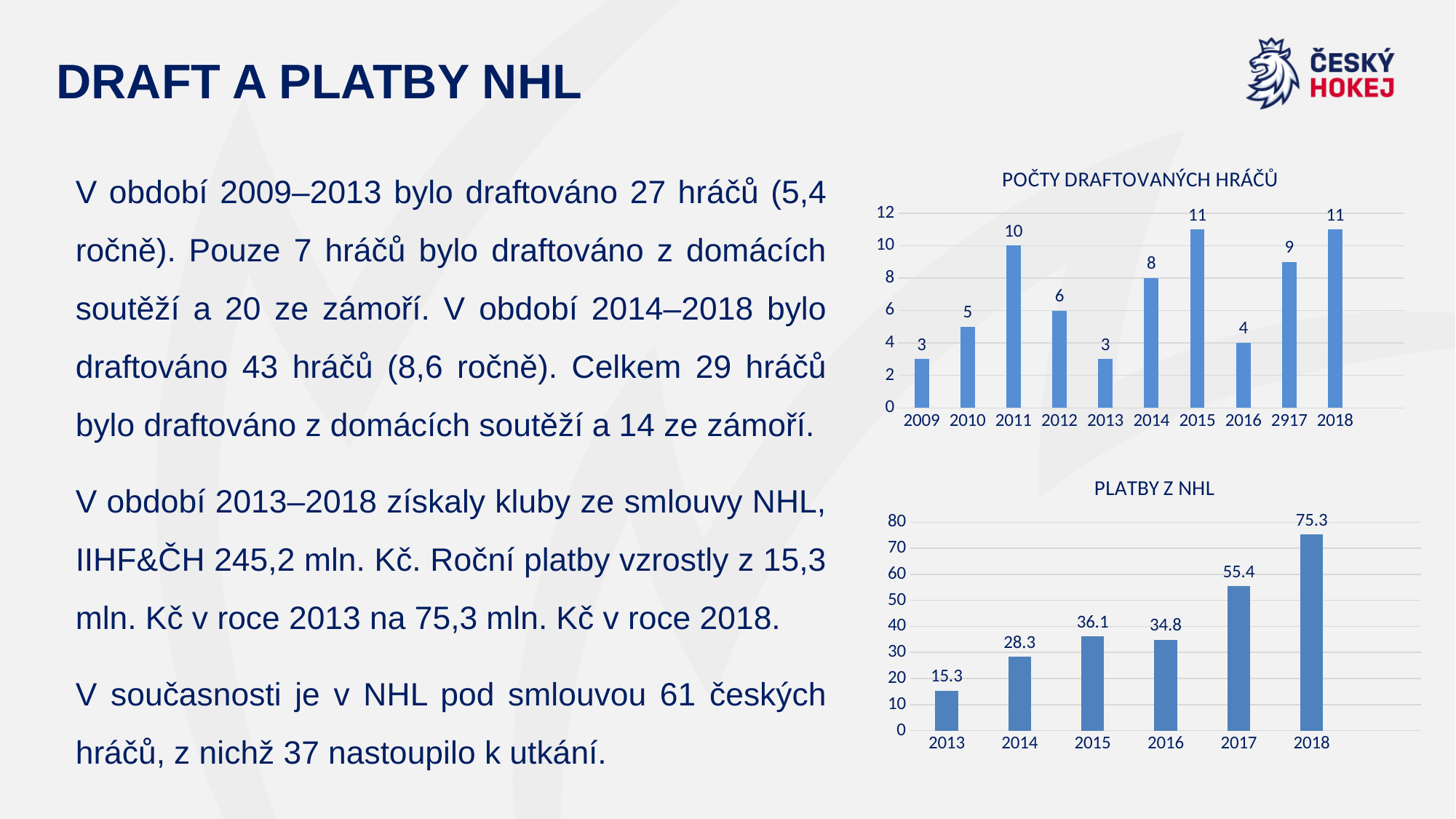
In the chart titled POČTY DRAFTOVANÝCH HRÁČŮ, which is larger, the value for 2012 or the value for 2013? 2012 In the chart titled PLATBY Z NHL, what is the value for 2017? 55.4 In the chart titled POČTY DRAFTOVANÝCH HRÁČŮ, what is the value for 2011? 10 In the chart titled PLATBY Z NHL, which is larger, the value for 2015 or the value for 2016? 2015 In the chart titled POČTY DRAFTOVANÝCH HRÁČŮ, how many years are shown on the x axis? 10 In the chart titled PLATBY Z NHL, which year has the lowest value? 2013 In the chart titled PLATBY Z NHL, what is the difference between the values for 2018 and 2013? 60 In the chart titled PLATBY Z NHL, which year has the highest value? 2018 In the chart titled POČTY DRAFTOVANÝCH HRÁČŮ, what is the value for 2016? 4 In the chart titled POČTY DRAFTOVANÝCH HRÁČŮ, what is the difference between the values for 2015 and 2014? 3 In the chart titled PLATBY Z NHL, how many bars are plotted? 6 What kind of chart is the chart titled POČTY DRAFTOVANÝCH HRÁČŮ? bar chart